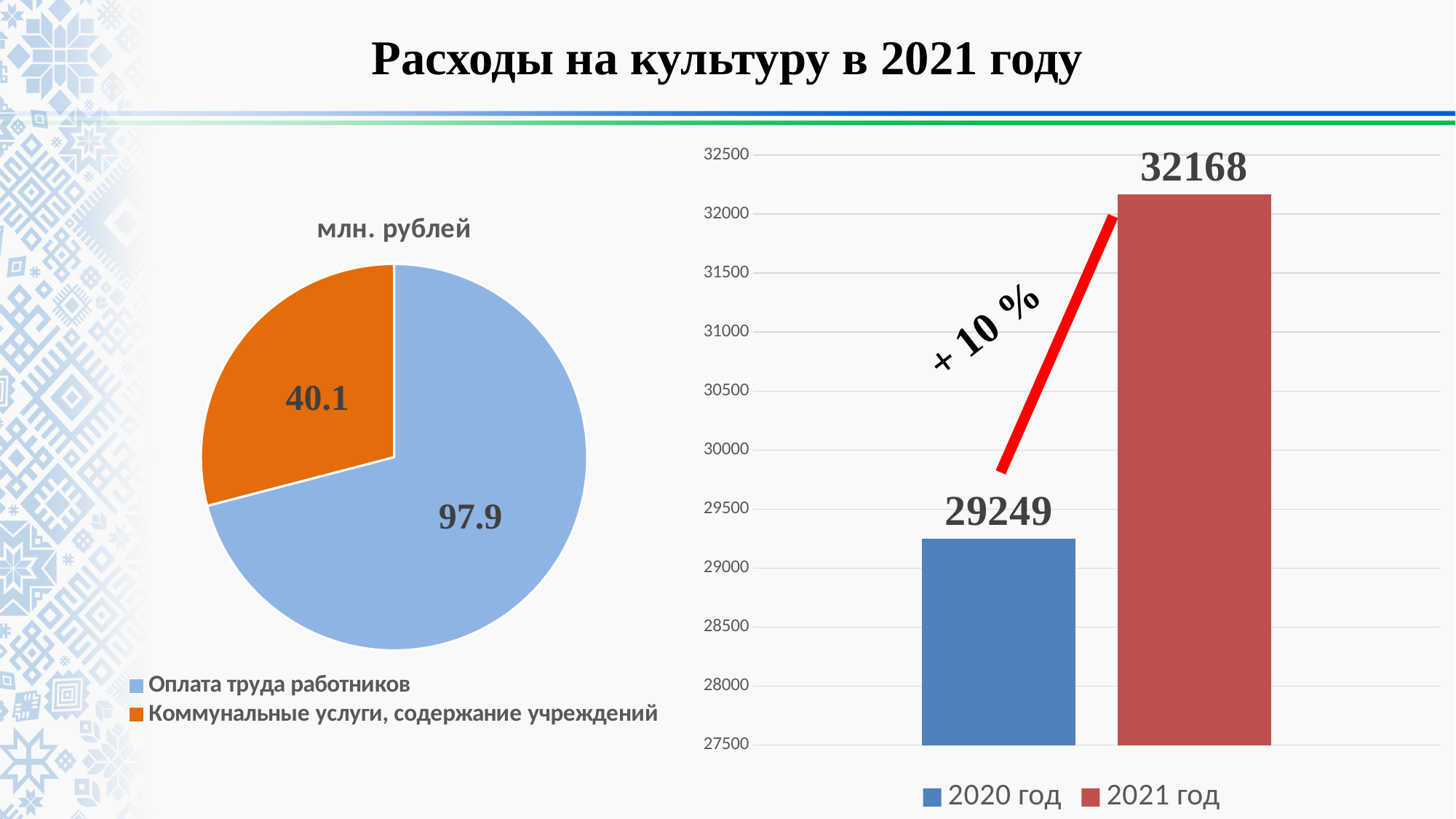
In the pie chart on the left, which category has the larger value? Оплата труда работников In the pie chart on the left, what is the total of the two slices? 138 In the bar chart on the right, what is the difference between the 2021 год and 2020 год values? 2919 In the bar chart on the right, which year has the higher value? 2021 год In the pie chart on the left, what is the value for Коммунальные услуги, содержание учреждений? 40.1 In the pie chart on the left, what is the difference between the two slice values? 57.8 In the bar chart on the right, what is the value for 2021 год? 32168 In the pie chart on the left, what is the value for Оплата труда работников? 97.9 In the bar chart on the right, what is the value for 2020 год? 29249 In the bar chart on the right, how many series does the legend list? 2 In the pie chart on the left, what unit is given in the chart title? млн. рублей What type of chart is shown on the right side of the slide? bar chart